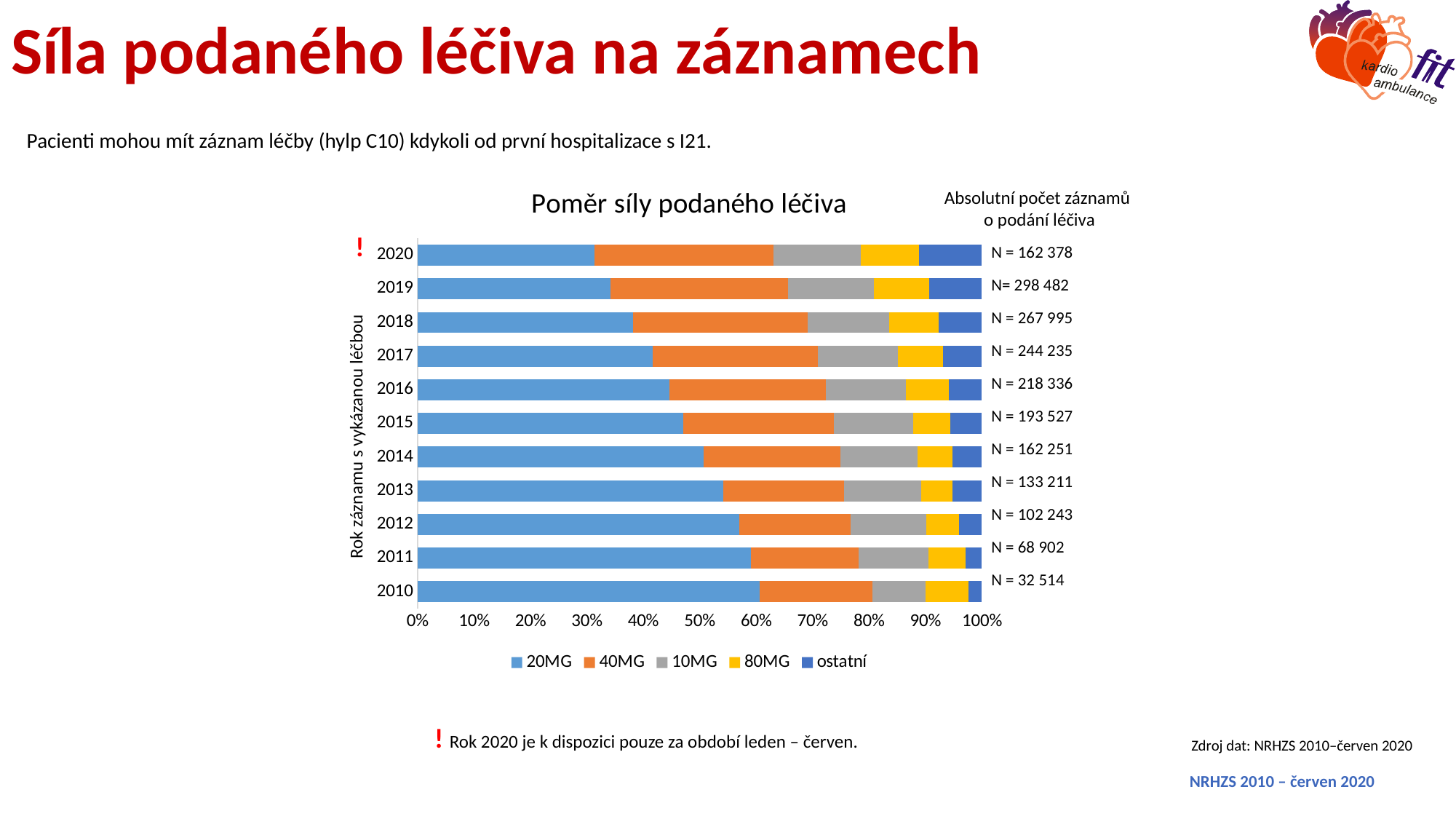
How many years (categories) are plotted on the chart? 11 Which year has the larger N value, 2016 or 2017? 2017 What kind of chart is shown on the slide? bar chart What is the title of the chart? Poměr síly podaného léčiva What is the absolute number of records (N) shown for 2020? 162 378 What is the absolute number of records (N) shown for 2010? 32 514 What is the difference between the N values for 2019 and 2018? 30 487 Does the 20MG share rise or fall from 2010 to 2020? fall How many series does the chart legend list? 5 Which year has the lowest absolute number of records (N)? 2010 Is the 20MG share for 2020 greater or less than 40%? less Which year has the highest absolute number of records (N)? 2019